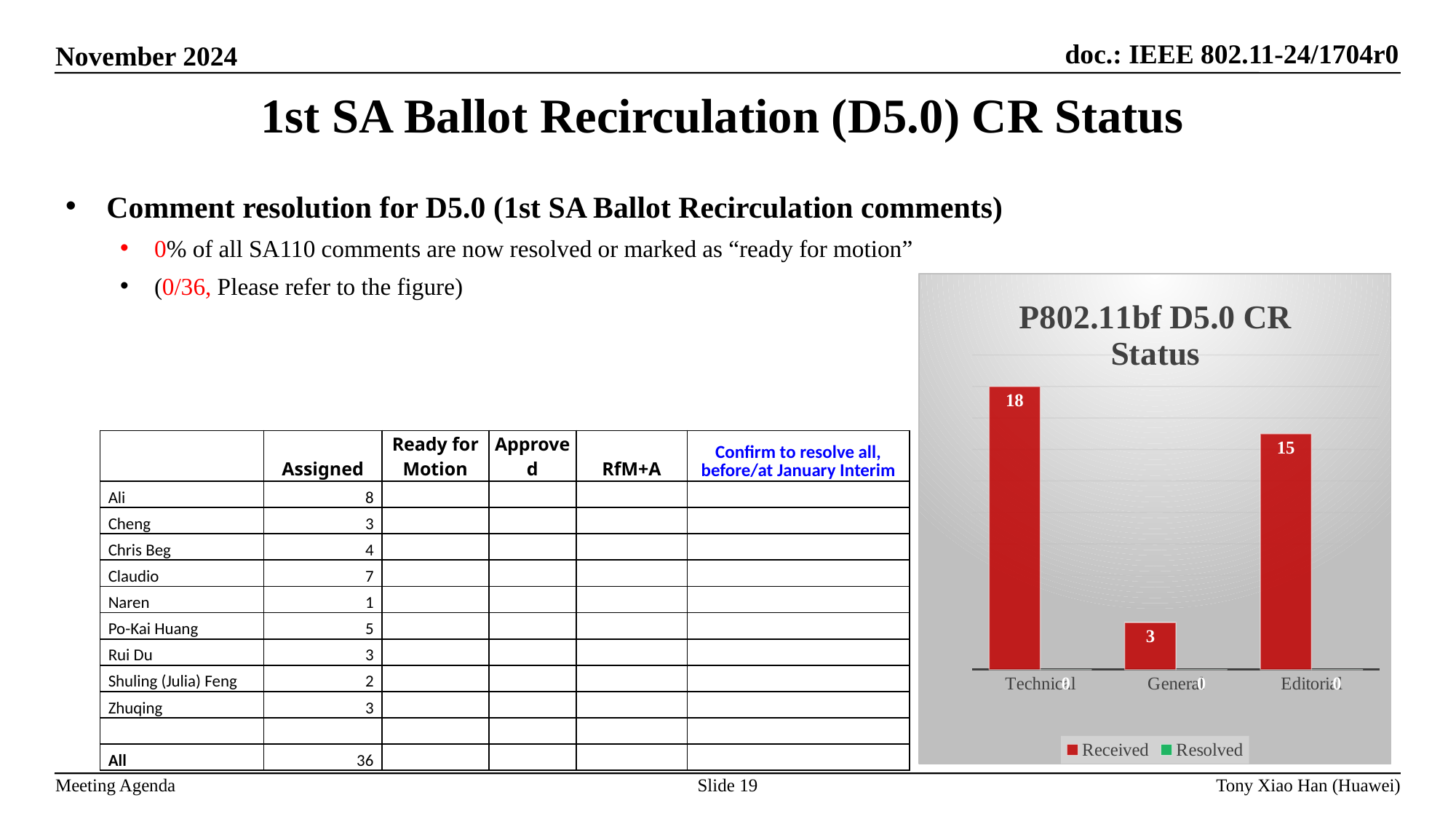
What is the difference between the Received values for Technical and Editorial? 3 What is the title of the chart on the slide? P802.11bf D5.0 CR Status What is the Received value for General? 3 How many categories are shown on the x axis of the chart? 3 What is the Received value for Technical? 18 Which category has the highest Received value? Technical How many series does the chart legend list? 2 What are the two series named in the chart legend? Received and Resolved Which has a larger Received value, General or Editorial? Editorial What is the Received value for Editorial? 15 Which category has the lowest Received value? General What kind of chart is shown on the slide? bar chart